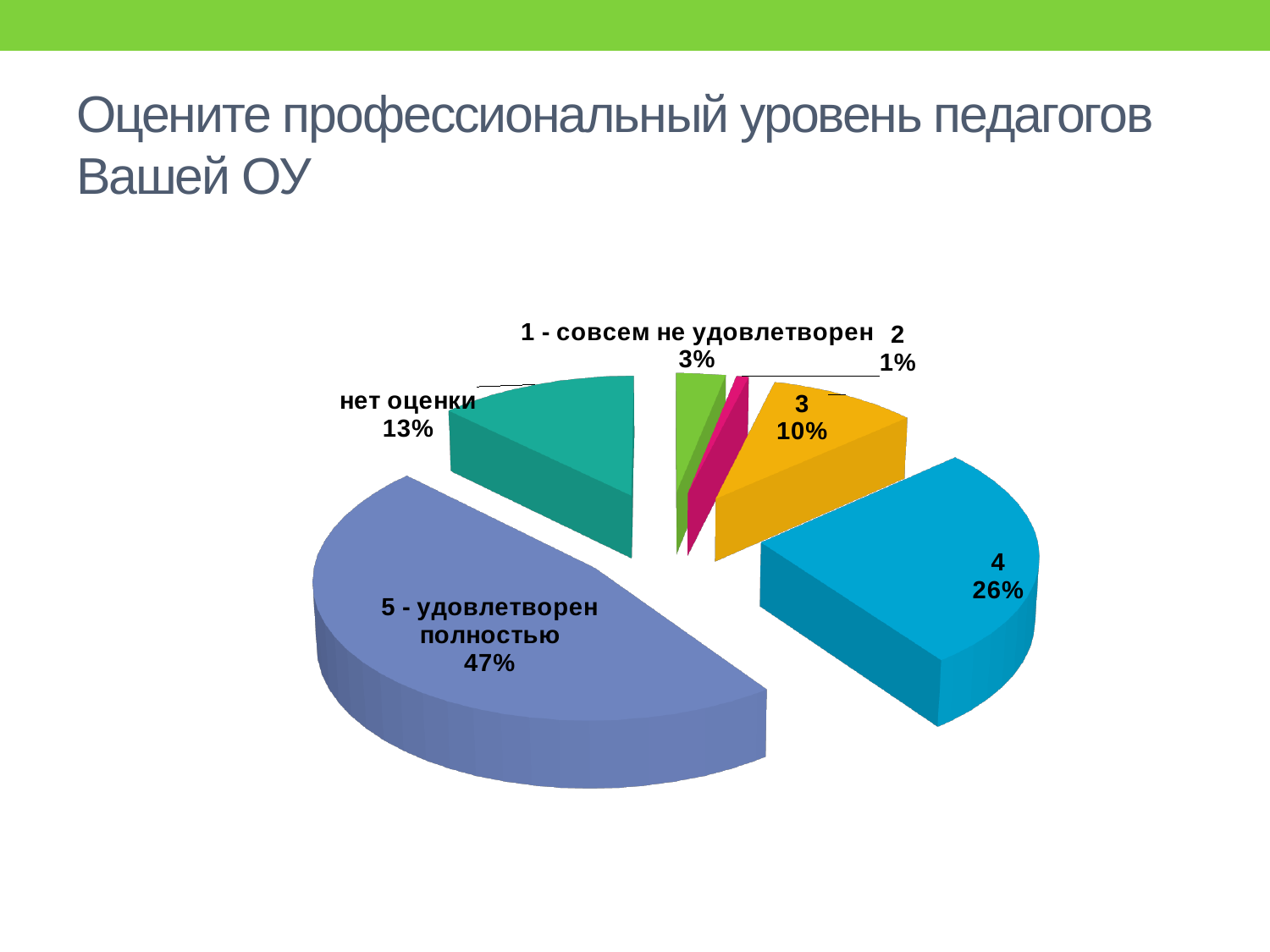
What is the value shown for category "2"? 1% What kind of chart is shown on the slide? pie chart What is the value shown for "1 - совсем не удовлетворен"? 3% Which category has the smallest share of the pie? 2 What is the value shown for category "3"? 10% What is the value shown for "нет оценки"? 13% What is the difference between the shares for "5 - удовлетворен полностью" and "4"? 21% Which is larger, the share for "нет оценки" or the share for "3"? нет оценки What share of the pie does "5 - удовлетворен полностью" have? 47% How many slices does the pie chart have? 6 Which category has the largest share of the pie? 5 - удовлетворен полностью What is the value shown for category "4"? 26%